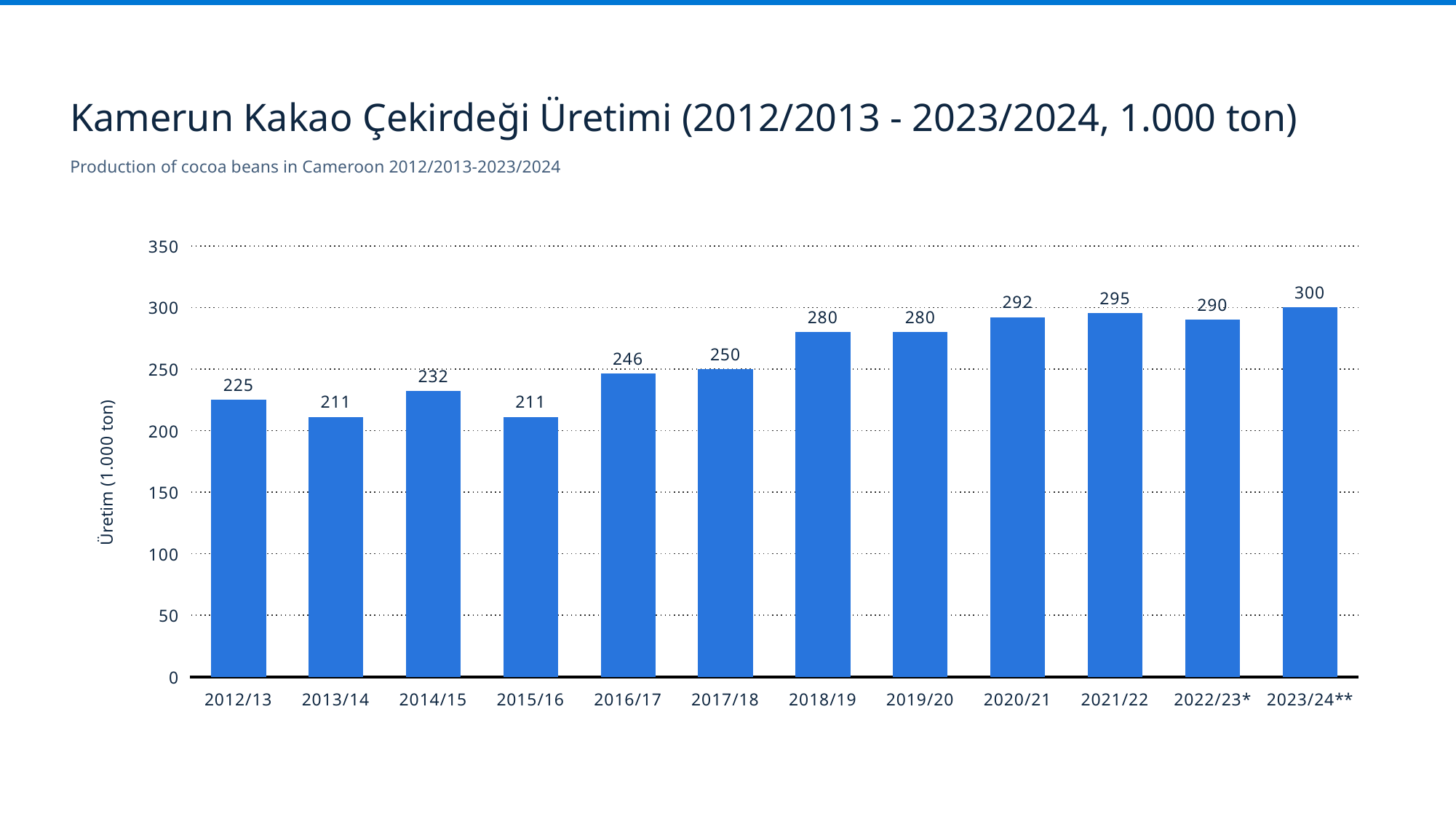
What kind of chart is shown on the slide? Bar chart Do the values generally rise or fall from 2015/16 to 2023/24**? Rise What is the label of the y axis? Üretim (1.000 ton) What is the difference between the values for 2023/24** and 2012/13? 75 What is the cocoa bean production value for 2016/17? 246 How many years (bars) are shown on the chart? 12 What is the lowest value shown on the chart? 211 What is the value shown for 2021/22? 295 Which year has the highest production value? 2023/24** What is the difference between the values for 2018/19 and 2017/18? 30 Which is larger, the value for 2020/21 or the value for 2022/23*? 2020/21 Is the value for 2017/18 greater or less than 200? greater